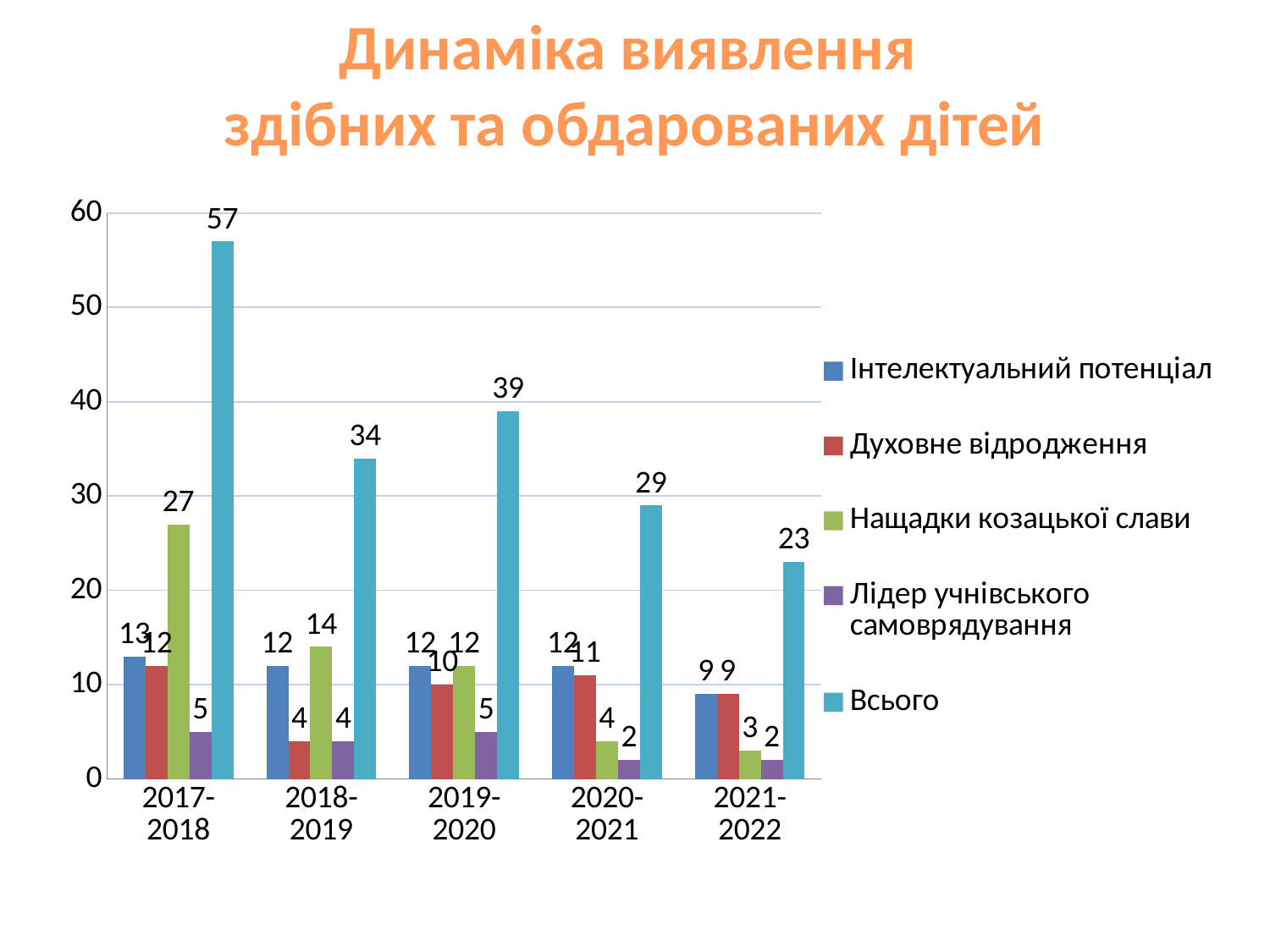
What is the value of Всього for 2017-2018? 57 How many periods are shown on the x axis? 5 Does the Всього value rise or fall from 2019-2020 to 2021-2022? Fall In which period is the Всього value the highest? 2017-2018 What is the value of Лідер учнівського самоврядування for 2020-2021? 2 What kind of chart is shown on the slide? Bar chart In which period is the Всього value the lowest? 2021-2022 Which is larger: Нащадки козацької слави in 2017-2018 or in 2019-2020? 2017-2018 What is the value of Духовне відродження for 2019-2020? 10 What is the difference between the Всього values for 2017-2018 and 2018-2019? 23 How many series does the legend list? 5 What is the value of Нащадки козацької слави for 2018-2019? 14